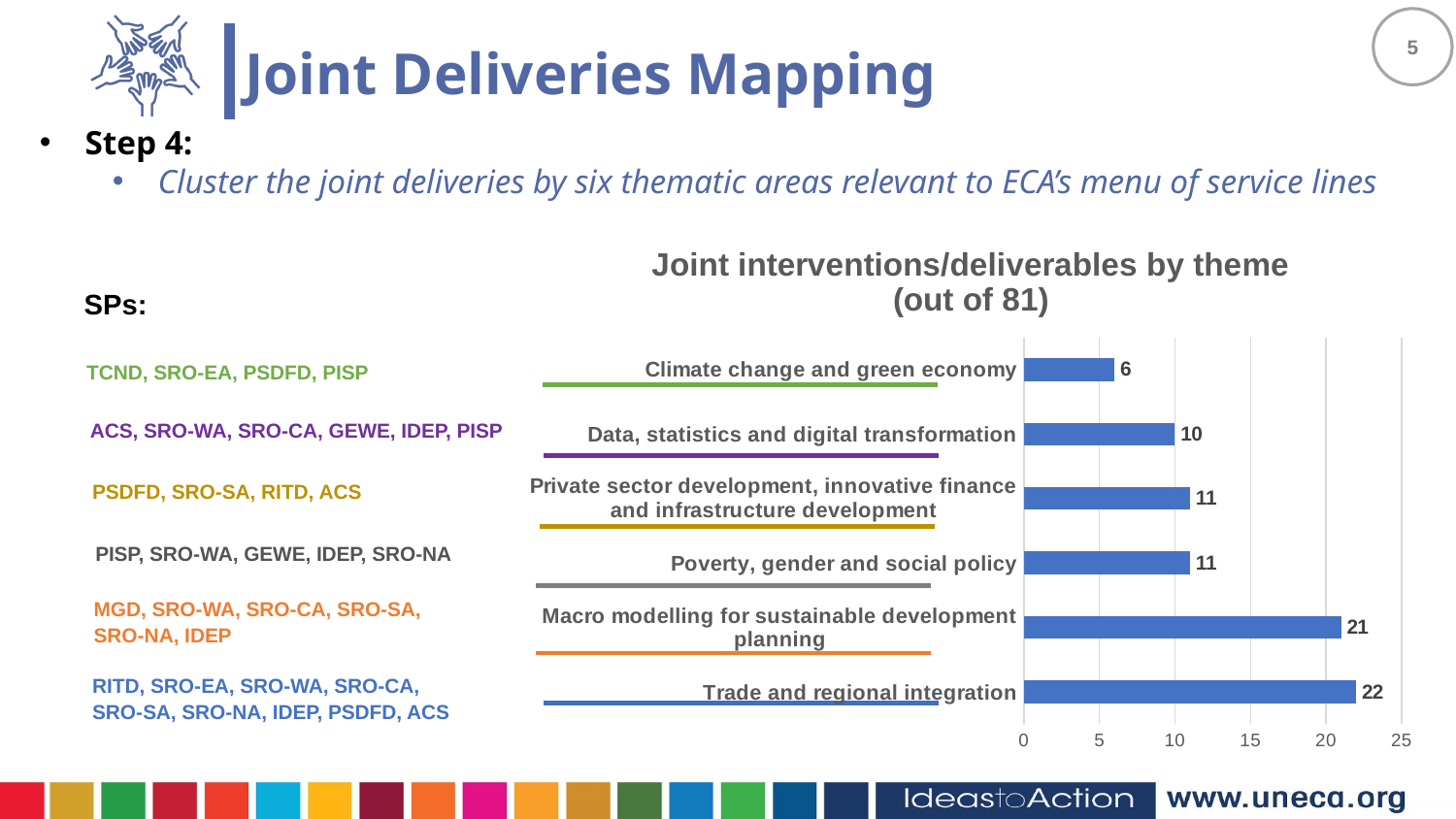
What is the title of the chart? Joint interventions/deliverables by theme (out of 81) What is the value for Data, statistics and digital transformation? 10 What is the value for Macro modelling for sustainable development planning? 21 What is the difference between the values for Trade and regional integration and Climate change and green economy? 16 Which theme has the highest number of joint interventions/deliverables? Trade and regional integration What kind of chart is shown on the slide? Bar chart How many themes are shown in the chart? 6 Which is larger: the value for Poverty, gender and social policy or the value for Data, statistics and digital transformation? Poverty, gender and social policy What is the value for Climate change and green economy? 6 What is the maximum value shown on the chart's horizontal axis? 25 What is the value for Trade and regional integration? 22 Which theme has the lowest number of joint interventions/deliverables? Climate change and green economy